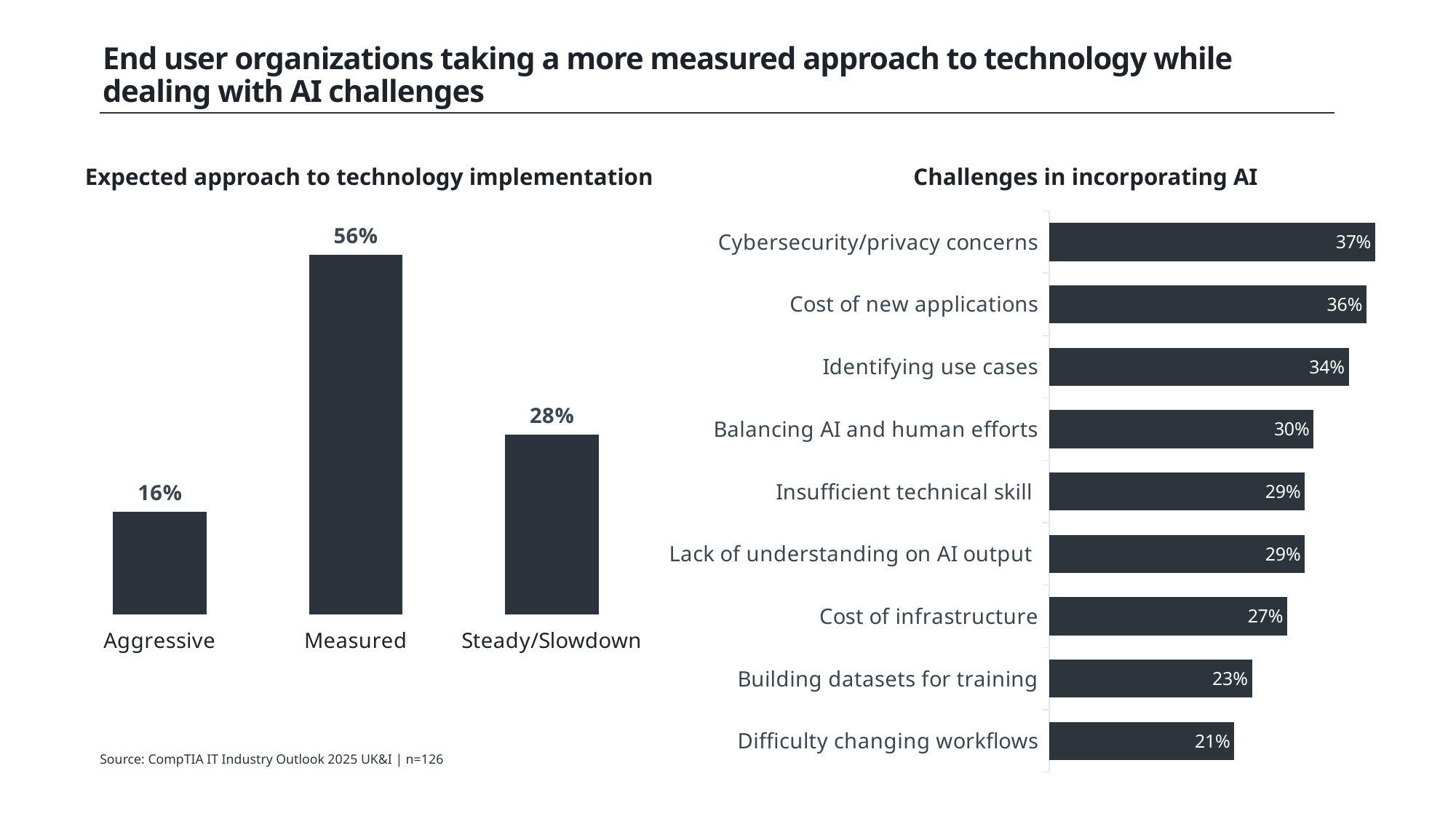
In the 'Challenges in incorporating AI' chart, which is larger: Balancing AI and human efforts or Cost of infrastructure? Balancing AI and human efforts In the 'Expected approach to technology implementation' chart, what is the value for Measured? 56% In the 'Challenges in incorporating AI' chart, what is the difference between Cost of new applications and Building datasets for training? 13% In the 'Challenges in incorporating AI' chart, which challenge has the lowest value? Difficulty changing workflows In the 'Challenges in incorporating AI' chart, what is the value for Identifying use cases? 34% In the 'Challenges in incorporating AI' chart, how many challenges are listed? 9 In the 'Challenges in incorporating AI' chart, which challenge has the highest value? Cybersecurity/privacy concerns In the 'Challenges in incorporating AI' chart, what is the value for Insufficient technical skill? 29% In the 'Expected approach to technology implementation' chart, which category has the lowest value? Aggressive In the 'Expected approach to technology implementation' chart, what kind of chart is it? Bar chart In the 'Expected approach to technology implementation' chart, how many categories are shown? 3 In the 'Expected approach to technology implementation' chart, what is the difference between Measured and Steady/Slowdown? 28%